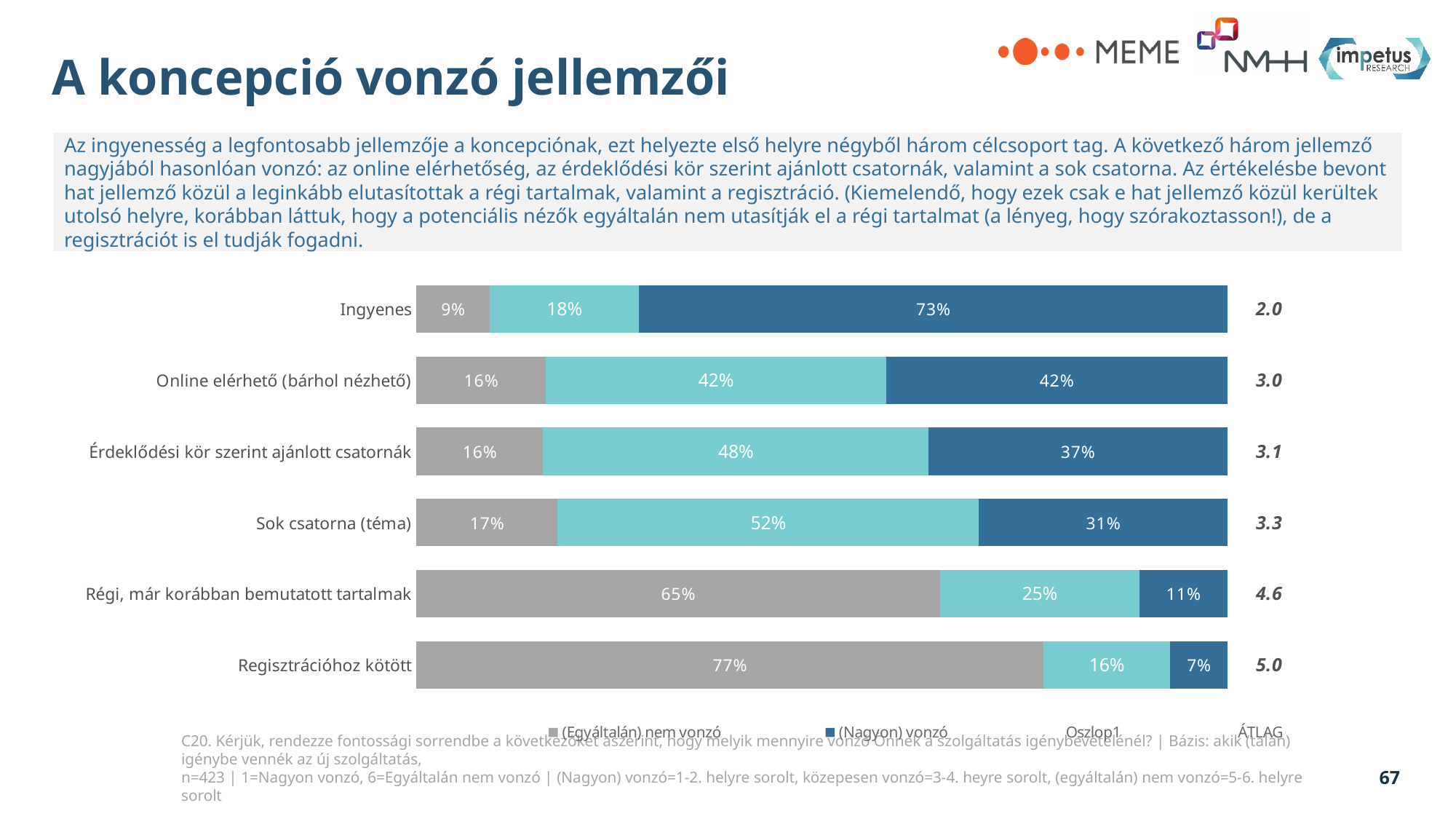
What is the ÁTLAG value shown for 'Sok csatorna (téma)'? 3.3 What is the ÁTLAG value for 'Ingyenes'? 2.0 What is the '(Egyáltalán) nem vonzó' value for 'Regisztrációhoz kötött'? 77% What is the middle (teal) segment value for 'Sok csatorna (téma)'? 52% Which category has the highest '(Nagyon) vonzó' value? Ingyenes Which is larger: the '(Nagyon) vonzó' value for 'Online elérhető (bárhol nézhető)' or for 'Érdeklődési kör szerint ajánlott csatornák'? Online elérhető (bárhol nézhető) What is the difference between the '(Egyáltalán) nem vonzó' values for 'Regisztrációhoz kötött' and 'Régi, már korábban bemutatott tartalmak'? 12% How many categories (rows) does the chart show? 6 What kind of chart is shown on the slide? stacked bar chart Which category has the highest ÁTLAG value? Regisztrációhoz kötött What is the '(Nagyon) vonzó' value for 'Ingyenes'? 73% Which category has the lowest '(Egyáltalán) nem vonzó' value? Ingyenes